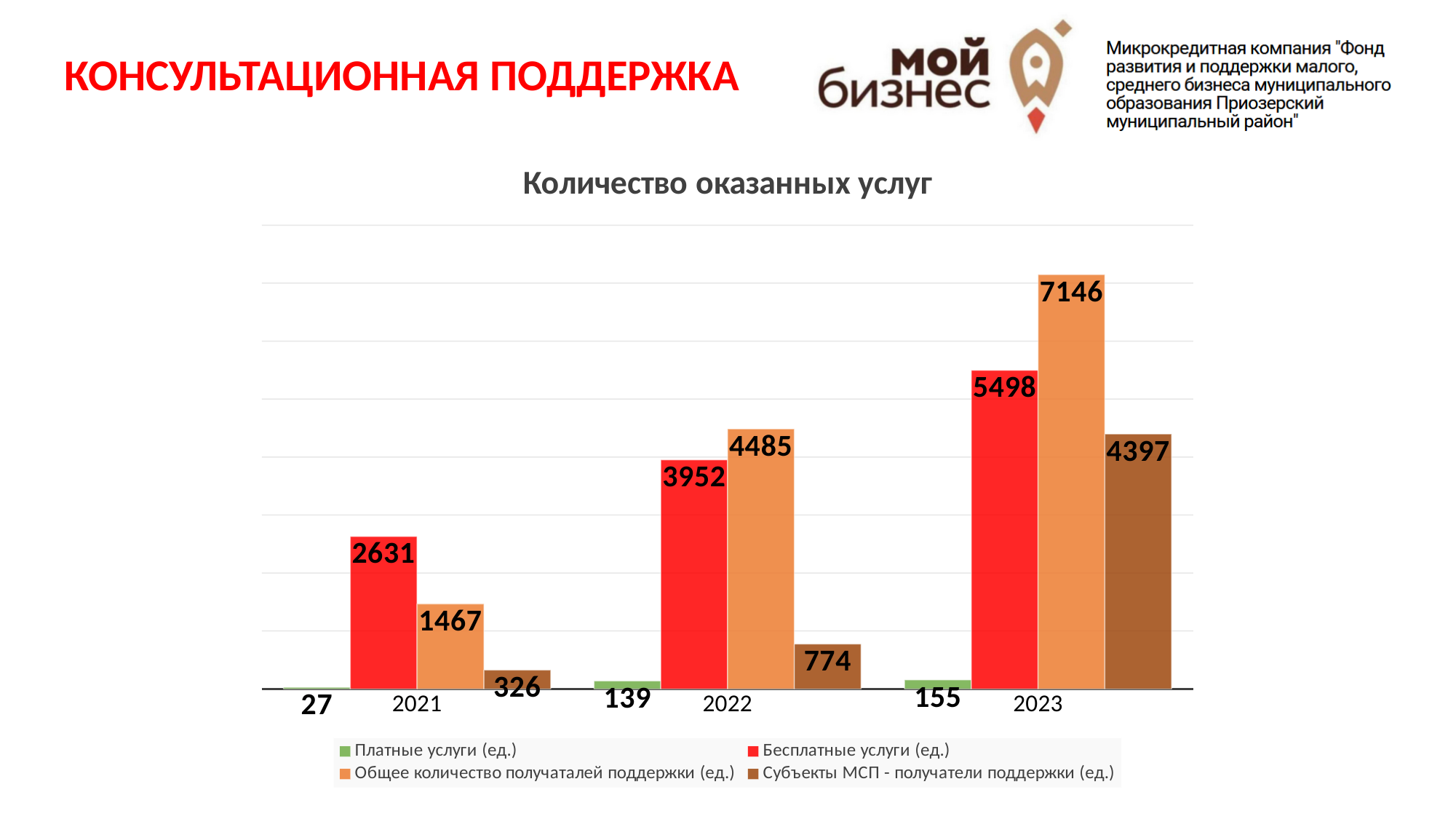
What is the value of Субъекты МСП - получатели поддержки (ед.) for 2023? 4397 What is the difference between Бесплатные услуги (ед.) in 2023 and in 2022? 1546 Do the values of Платные услуги (ед.) rise or fall from 2021 to 2023? Rise In which year is Общее количество получаталей поддержки (ед.) highest? 2023 In which year is Субъекты МСП - получатели поддержки (ед.) lowest? 2021 How many years are shown on the x axis? 3 What is the value of Платные услуги (ед.) for 2021? 27 Which is larger in 2022: Бесплатные услуги (ед.) or Общее количество получаталей поддержки (ед.)? Общее количество получаталей поддержки (ед.) How many series does the legend list? 4 What kind of chart is shown on the slide? Bar chart What is the value of Бесплатные услуги (ед.) for 2022? 3952 What is the value of Общее количество получаталей поддержки (ед.) for 2021? 1467